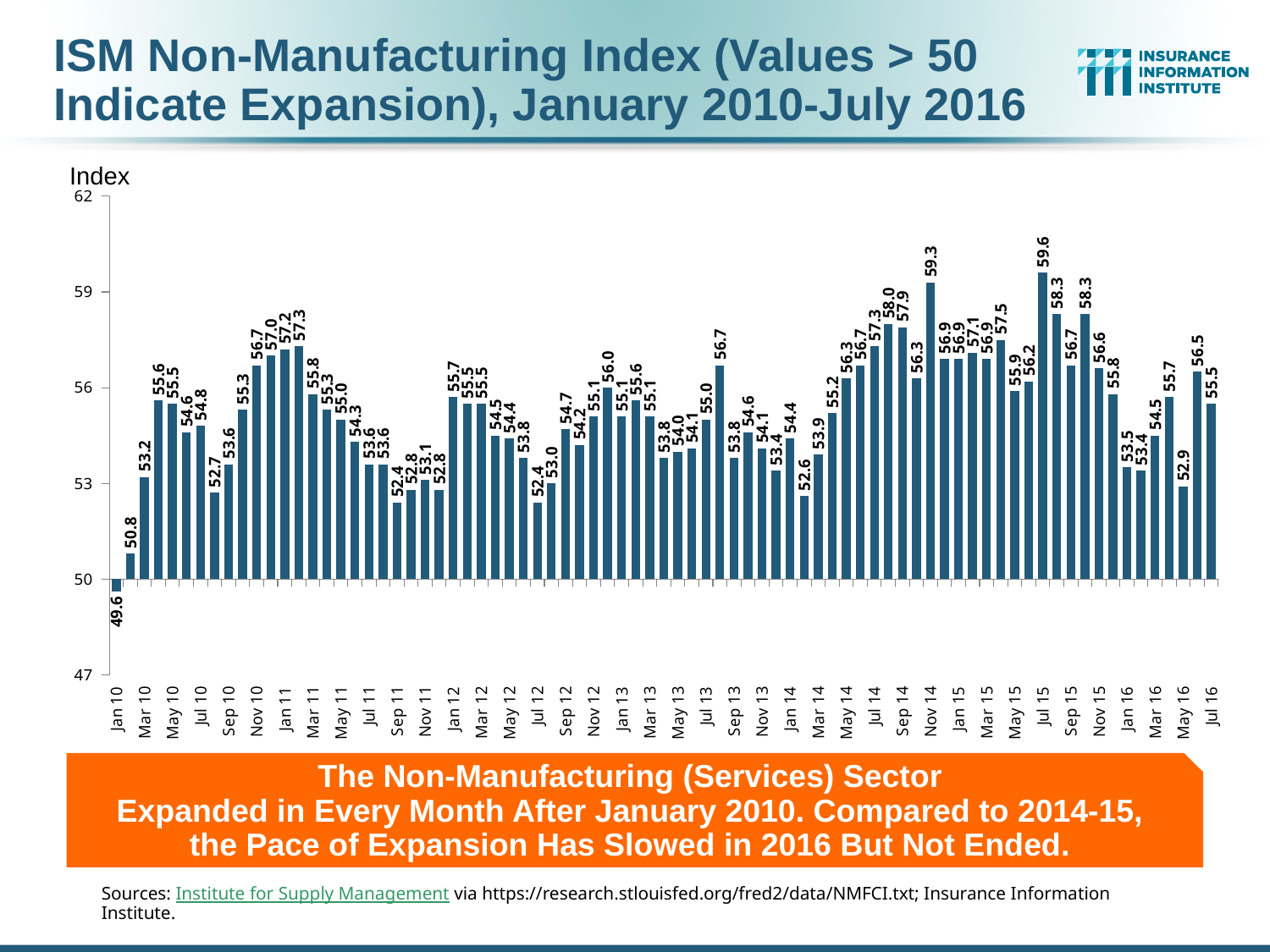
What is the label on the vertical axis of the chart? Index What is the index value for Nov 14? 59.3 Which month has the highest index value on the chart? Jul 15 What is the difference between the index values for Jul 15 and Jan 10? 10.0 What kind of chart is shown on the slide? Bar chart How many monthly bars are plotted on the chart? 79 Is the index value for Jan 10 greater or less than 50? less What is the index value for Jul 15? 59.6 What is the index value for Jul 16, the last month shown? 55.5 What is the ISM Non-Manufacturing Index value for Jan 10? 49.6 Which is larger, the index value for Nov 14 or for Jul 15? Jul 15 Which month has the lowest index value on the chart? Jan 10